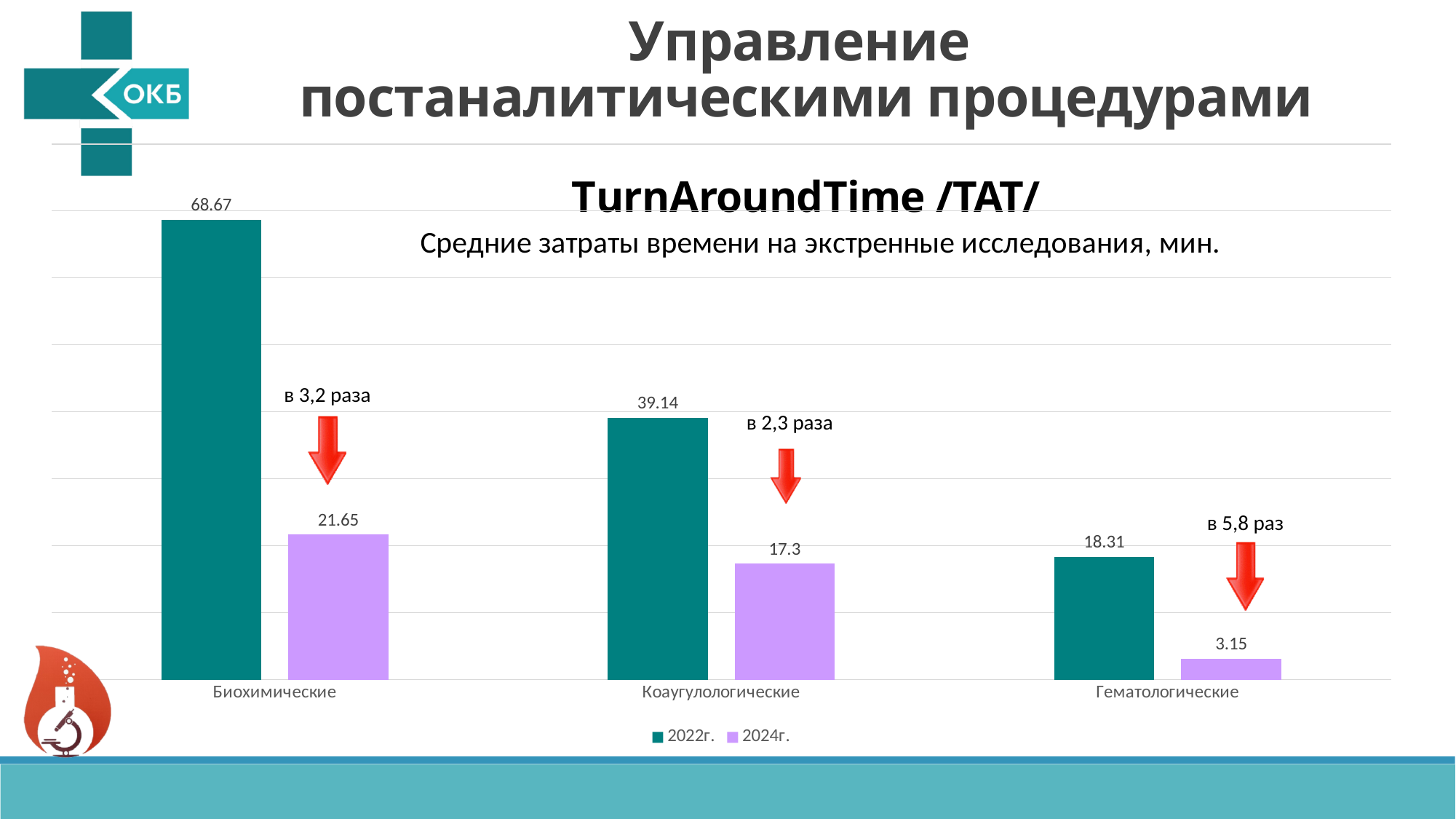
How many categories are shown on the x axis? 3 What is the 2024г. value for Гематологические? 3.15 How many series does the legend list? 2 What is the difference between the 2022г. and 2024г. values for Биохимические? 47.02 Which category has the highest 2022г. value? Биохимические Which category has the lowest 2024г. value? Гематологические What kind of chart is shown on the slide? Bar chart What is the 2022г. value for Биохимические? 68.67 What is the 2022г. value for Гематологические? 18.31 What is the difference between the 2022г. and 2024г. values for Коаугулологические? 21.84 Which is larger: the 2024г. value for Биохимические or the 2022г. value for Гематологические? 2024г. value for Биохимические What is the 2024г. value for Коаугулологические? 17.3